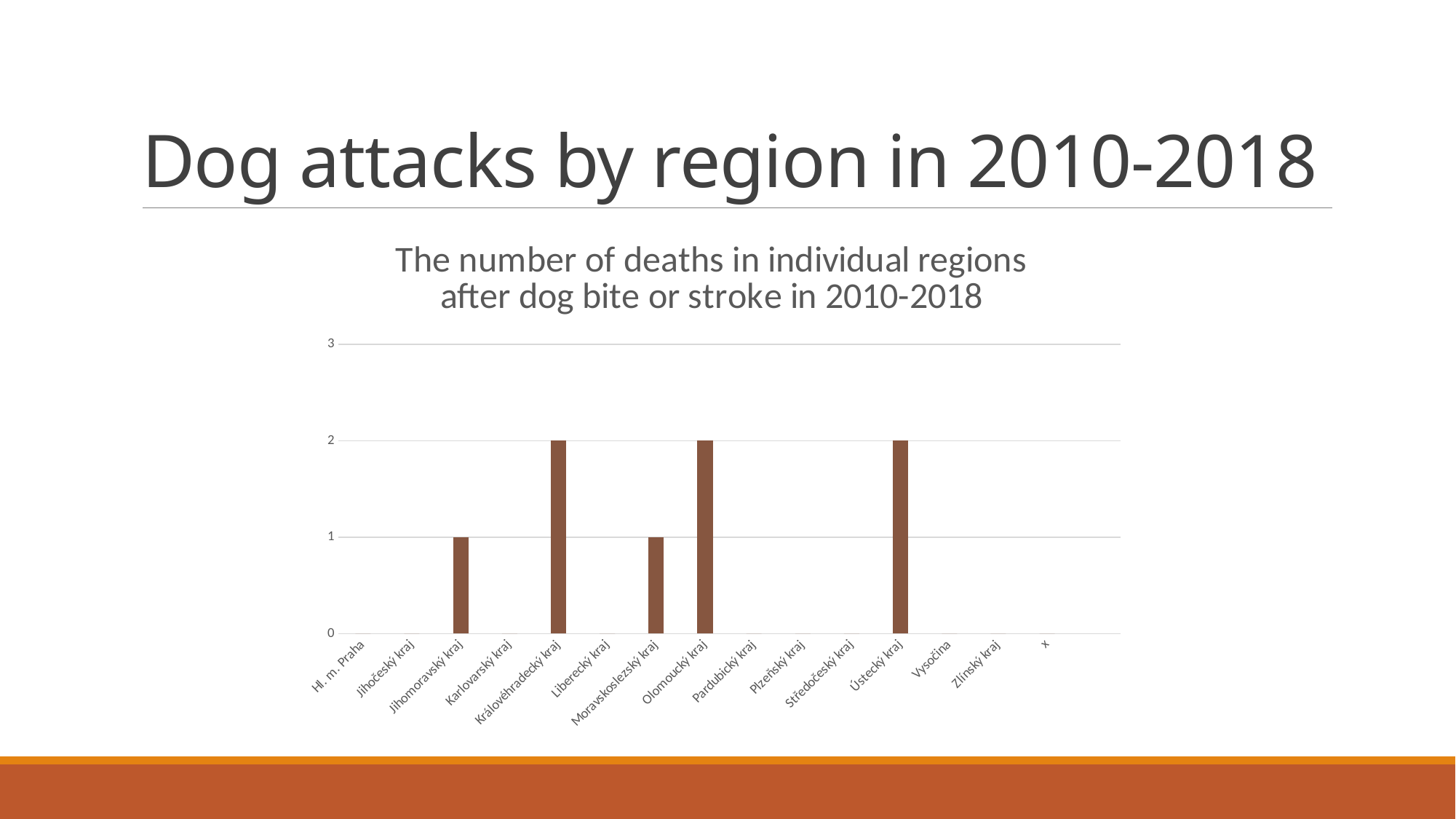
What is the title of the chart? The number of deaths in individual regions after dog bite or stroke in 2010-2018 Which has a larger value, Olomoucký kraj or Moravskoslezský kraj? Olomoucký kraj Is the value for Ústecký kraj greater or less than 1? greater What is the value for Ústecký kraj? 2 What is the value for Královéhradecký kraj? 2 What kind of chart is shown on the slide? bar chart What is the value for Moravskoslezský kraj? 1 How many regions have a bar with a value above 0? 5 What is the value for Olomoucký kraj? 2 What is the difference between the values for Královéhradecký kraj and Jihomoravský kraj? 1 How many categories are shown on the x axis? 15 What is the value for Jihomoravský kraj? 1